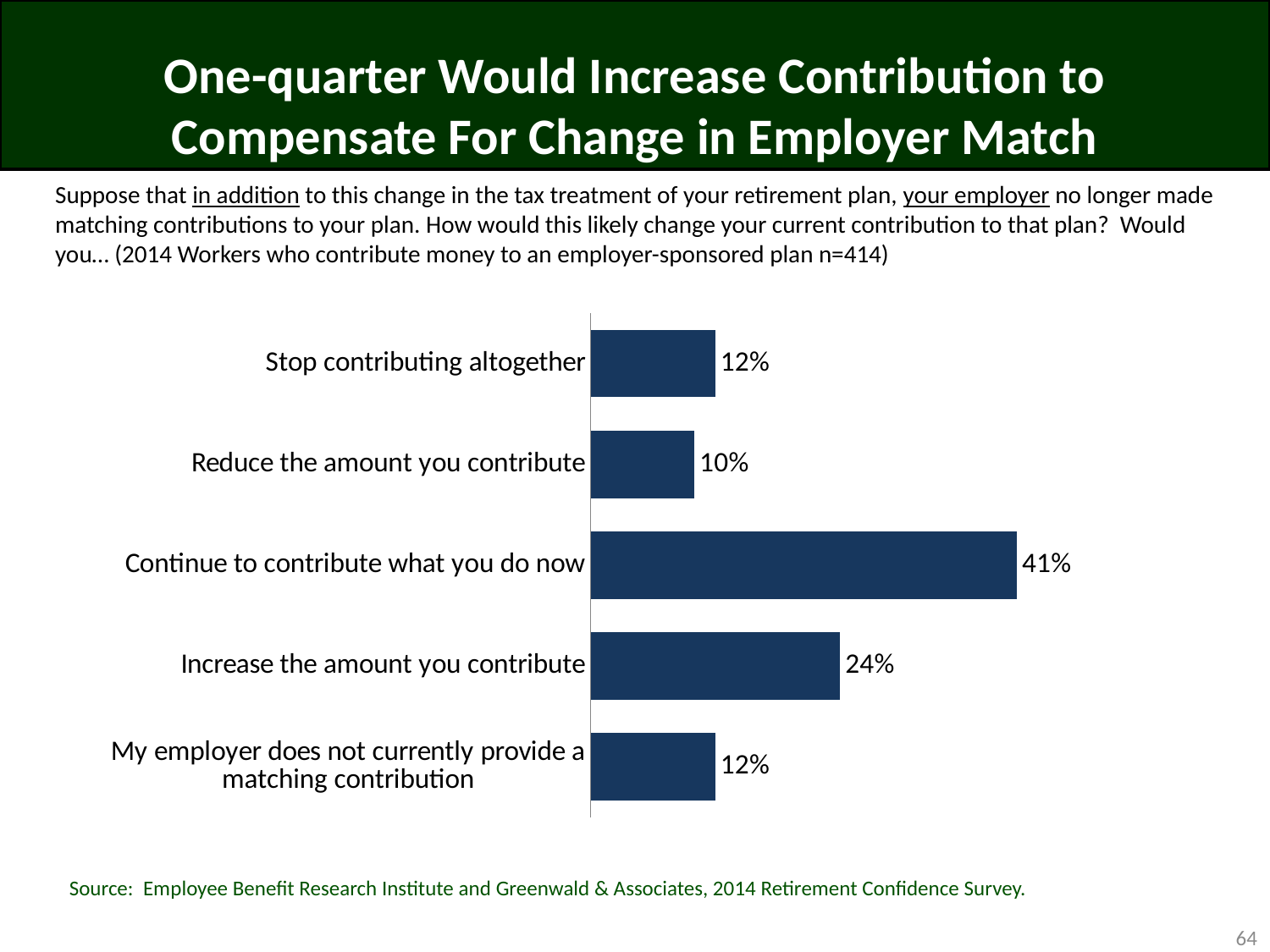
What percentage of workers would increase the amount they contribute? 24% What percentage of workers would stop contributing altogether? 12% Which response has the lowest percentage? Reduce the amount you contribute Which response has the highest percentage? Continue to contribute what you do now What percentage of workers would reduce the amount they contribute? 10% Which is larger: the percentage for 'Increase the amount you contribute' or for 'Stop contributing altogether'? Increase the amount you contribute How many response categories are shown in the chart? 5 What type of chart is shown on the slide? Bar chart What percentage of workers would continue to contribute what they do now? 41% What is the sample size (n) stated for the 2014 workers who contribute to an employer-sponsored plan? 414 What percentage of workers said their employer does not currently provide a matching contribution? 12% What is the difference in percentage points between 'Continue to contribute what you do now' and 'Increase the amount you contribute'? 17